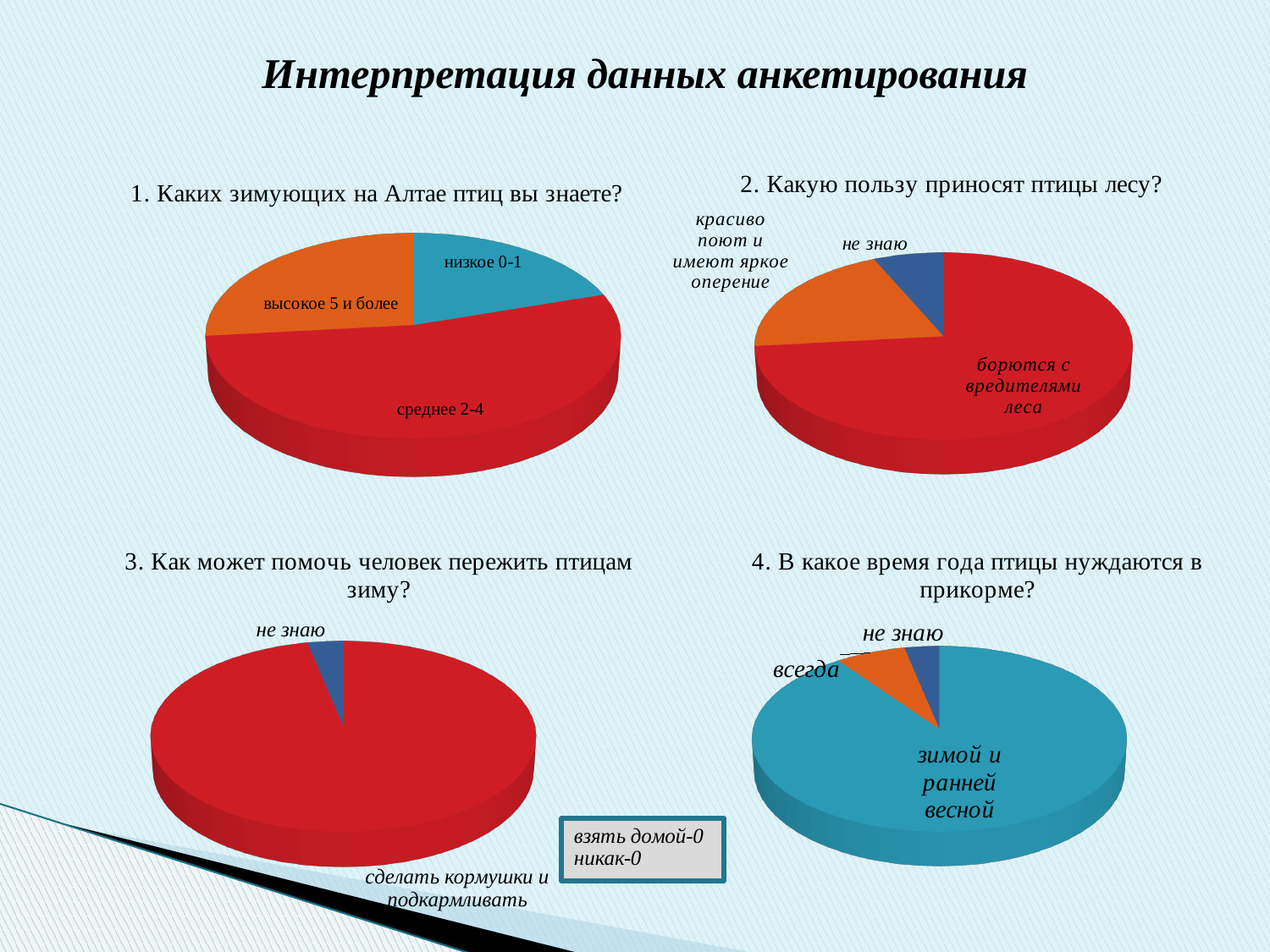
In the chart for question 1 ("Каких зимующих на Алтае птиц вы знаете?"), which category has the largest slice? среднее 2-4 In the chart for question 2 ("Какую пользу приносят птицы лесу?"), which slice is larger: "красиво поют и имеют яркое оперение" or "не знаю"? красиво поют и имеют яркое оперение In the chart for question 2 ("Какую пользу приносят птицы лесу?"), which category has the smallest slice? не знаю In the chart for question 4 ("В какое время года птицы нуждаются в прикорме?"), which slice is larger: "всегда" or "не знаю"? всегда In the chart for question 4 ("В какое время года птицы нуждаются в прикорме?"), which category has the largest slice? зимой и ранней весной What colour is the "зимой и ранней весной" slice in the chart for question 4? Teal (blue-green) How many slices does the pie chart for question 1 ("Каких зимующих на Алтае птиц вы знаете?") have? 3 In the chart for question 2 ("Какую пользу приносят птицы лесу?"), which category has the largest slice? борются с вредителями леса How many slices are visible in the pie chart for question 3 ("Как может помочь человек пережить птицам зиму?")? 2 What kind of chart is used for question 1, "Каких зимующих на Алтае птиц вы знаете?"? Pie chart How many pie charts are shown on the slide? 4